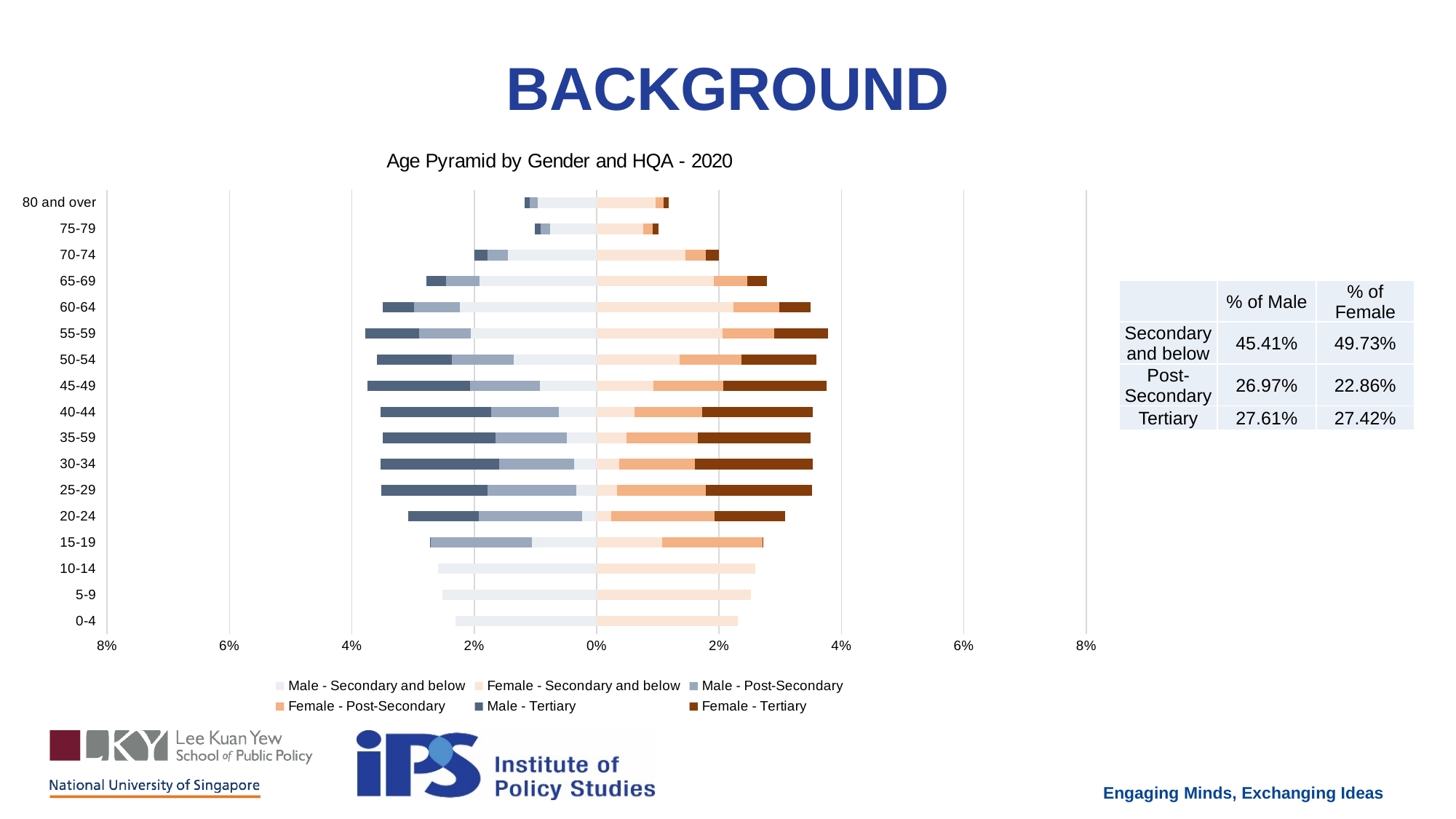
Is the total female value for the 45-49 age group greater or less than 2%? greater How many age groups are shown on the vertical axis of the chart? 17 Is the total male value for the 0-4 age group greater or less than 4%? less What kind of chart is shown on the slide? Stacked bar chart (population pyramid) Which is larger: the total female bar for 25-29 or the total female bar for 75-79? 25-29 What is the title of the chart? Age Pyramid by Gender and HQA - 2020 How many series does the chart legend list? 6 What is the highest percentage tick shown on the horizontal axis of the chart? 8% How many age groups show only a Secondary and below segment with no Post-Secondary or Tertiary segment? 3 Which is larger: the total male bar for 45-49 or the total male bar for 80 and over? 45-49 Moving from the 55-59 age group up to 80 and over, do the male bars get longer or shorter? shorter Is the total male value for the 80 and over age group greater or less than 2%? less